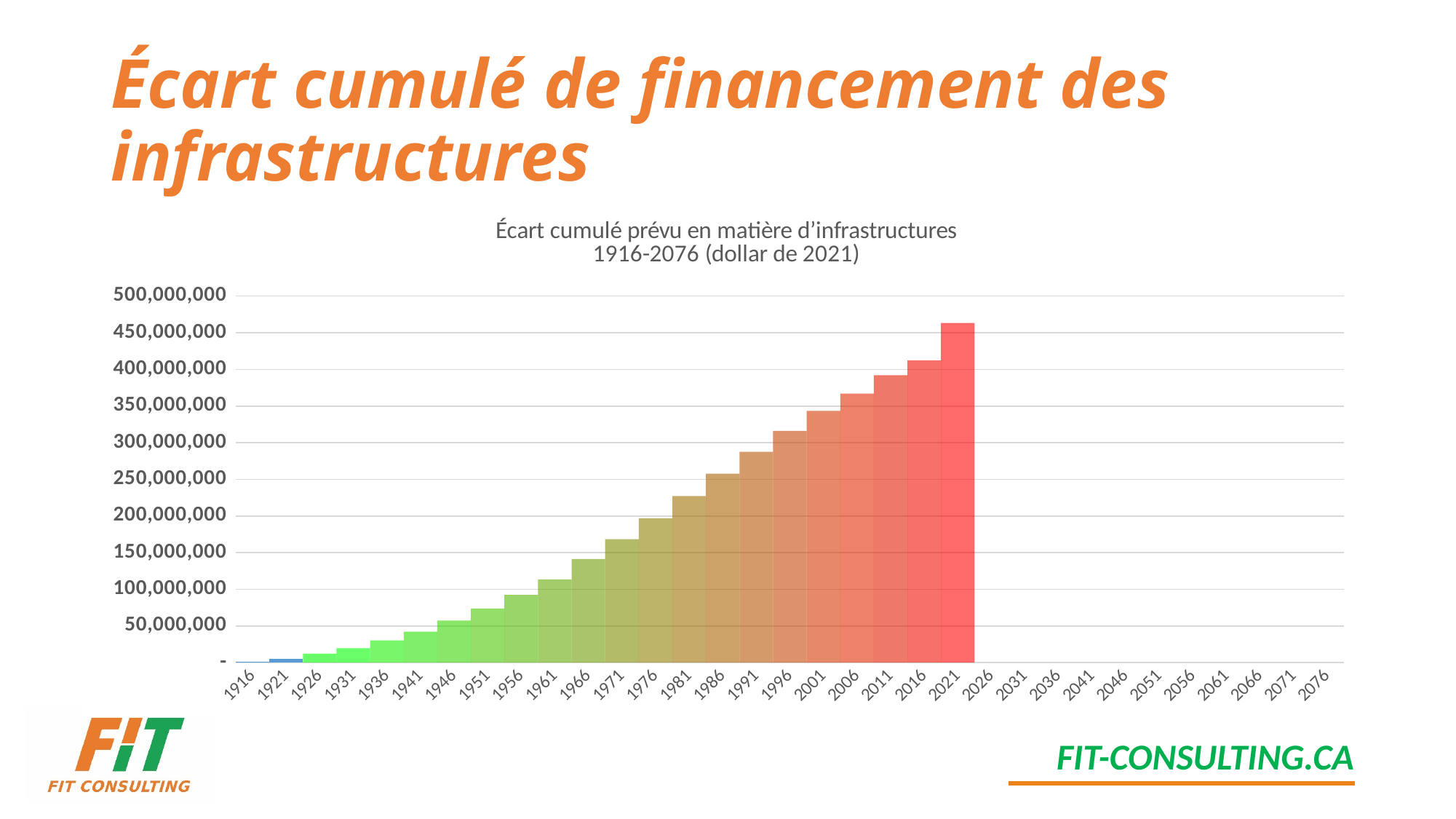
What kind of chart is shown on the slide? bar chart Is the value for 1956 greater or less than 100,000,000? less Which year has the tallest bar? 2021 How many year labels are shown on the x axis? 33 Which is larger, the value for 1986 or the value for 1961? 1986 Is the value for 1996 greater or less than 300,000,000? greater Do the bar values rise or fall from 1916 to 2021? rise What is the title of the chart? Écart cumulé prévu en matière d'infrastructures 1916-2076 (dollar de 2021) Is the value for 2021 greater or less than 450,000,000? greater What colour is the bar for 2021? red